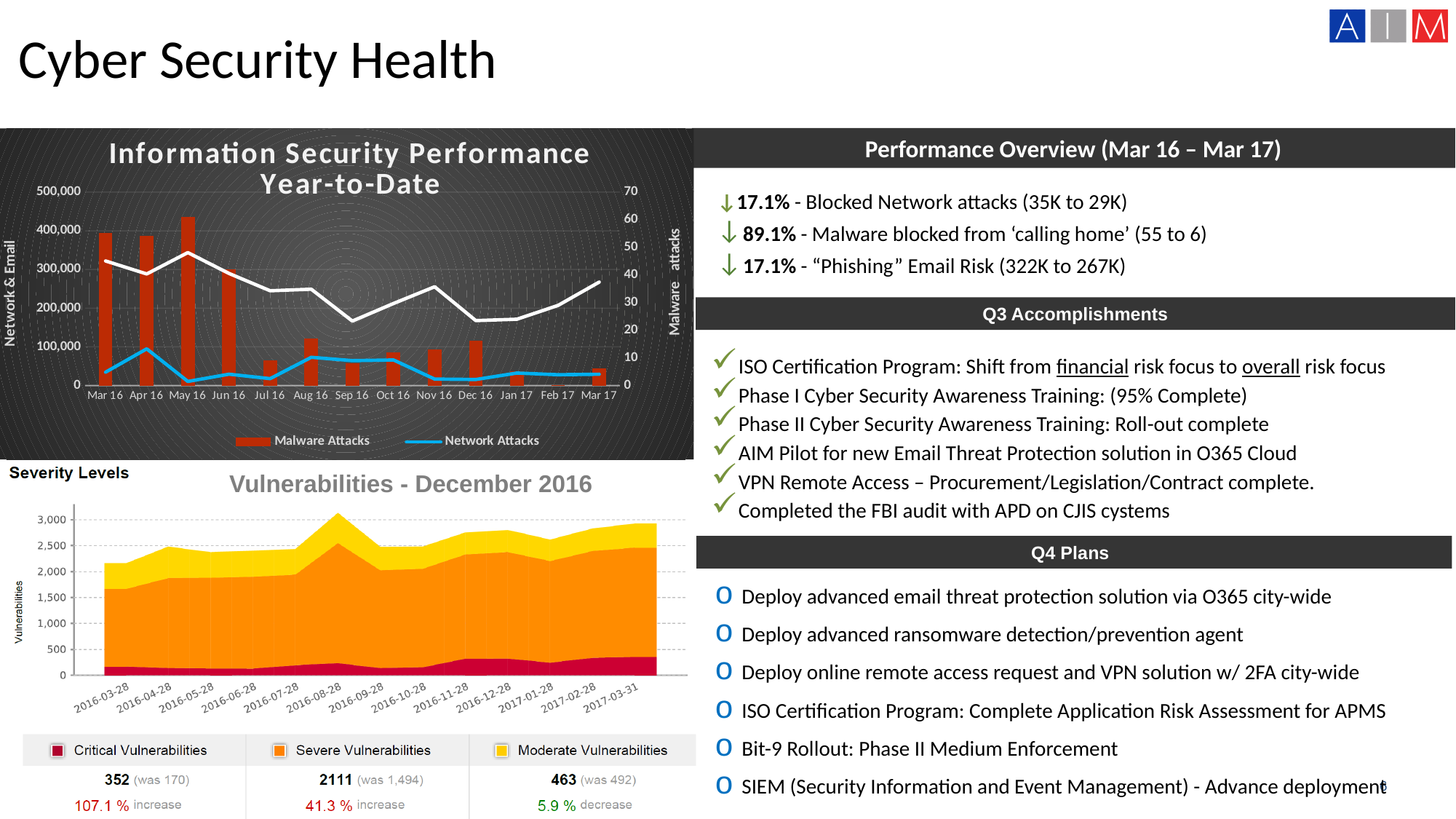
What kind of chart is 'Vulnerabilities - December 2016'? Stacked area chart How many series does the legend of the 'Information Security Performance Year-to-Date' chart list? 2 In the 'Vulnerabilities - December 2016' chart, what is the current value shown for Severe Vulnerabilities? 2111 In the 'Vulnerabilities - December 2016' chart, what was the previous value shown for Critical Vulnerabilities? 170 In the 'Vulnerabilities - December 2016' chart, what percentage change is shown for Moderate Vulnerabilities? 5.9 % decrease What is the label of the right-hand vertical axis in the 'Information Security Performance Year-to-Date' chart? Malware attacks In the 'Information Security Performance Year-to-Date' chart, is the Malware Attacks value for Jul 16 greater or less than 100,000? less In the 'Information Security Performance Year-to-Date' chart, which month has the highest Malware Attacks bar? May 16 How many series does the legend of the 'Vulnerabilities - December 2016' chart list? 3 In the 'Information Security Performance Year-to-Date' chart, which is larger, the Malware Attacks bar for Apr 16 or for Aug 16? Apr 16 How many months are shown on the x axis of the 'Information Security Performance Year-to-Date' chart? 13